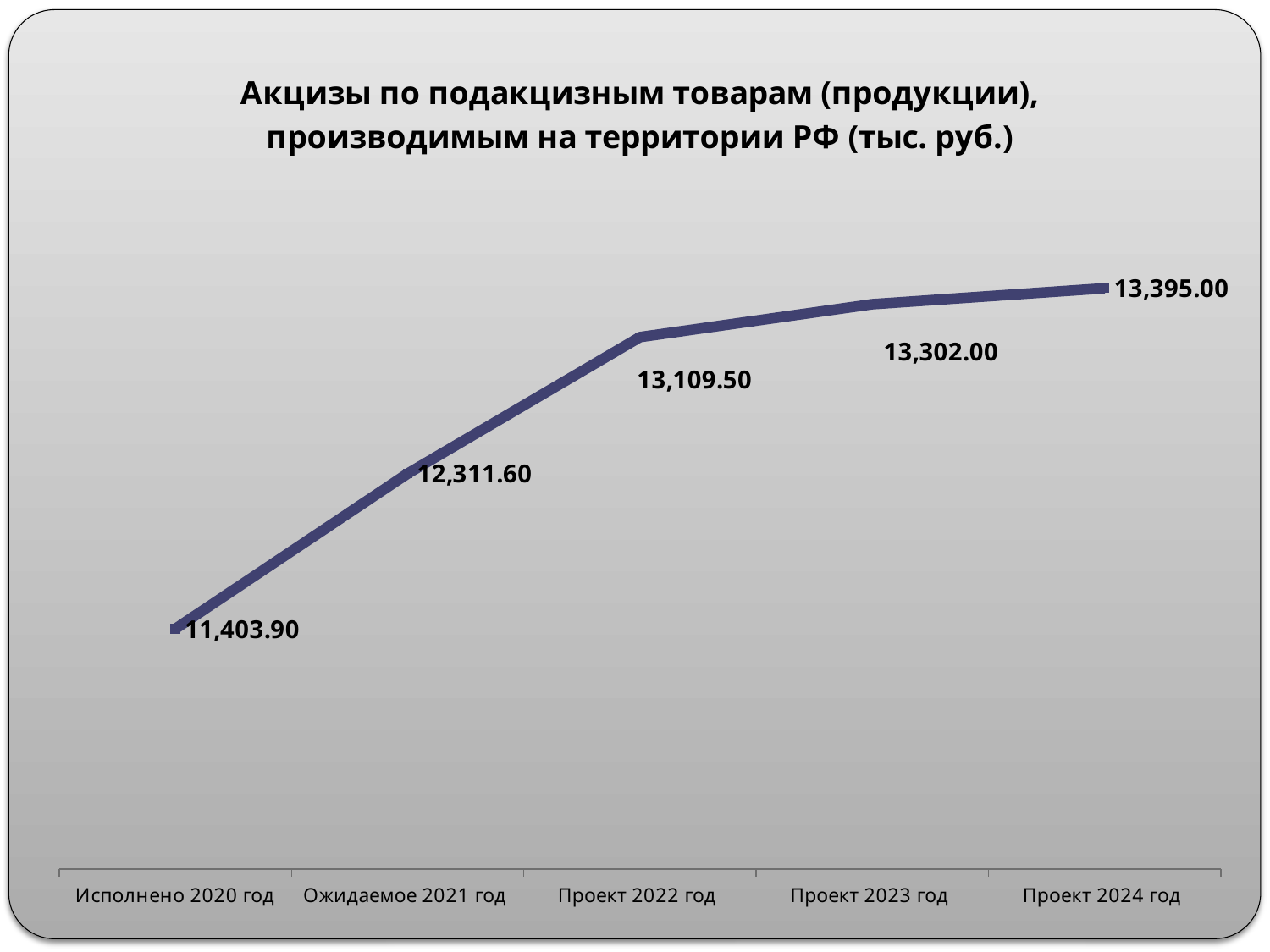
Do the values rise or fall from Исполнено 2020 год to Проект 2024 год? Rise What is the value for Исполнено 2020 год? 11,403.90 What is the value for Проект 2022 год? 13,109.50 Which category has the highest value? Проект 2024 год Which is larger, the value for Ожидаемое 2021 год or the value for Проект 2023 год? Проект 2023 год What is the difference between the values for Проект 2024 год and Исполнено 2020 год? 1,991.10 What is the value for Проект 2024 год? 13,395.00 What kind of chart is shown on the slide? Line chart What is the value for Ожидаемое 2021 год? 12,311.60 Which category has the lowest value? Исполнено 2020 год How many data points are plotted on the chart? 5 What is the difference between the values for Проект 2023 год and Проект 2022 год? 192.50